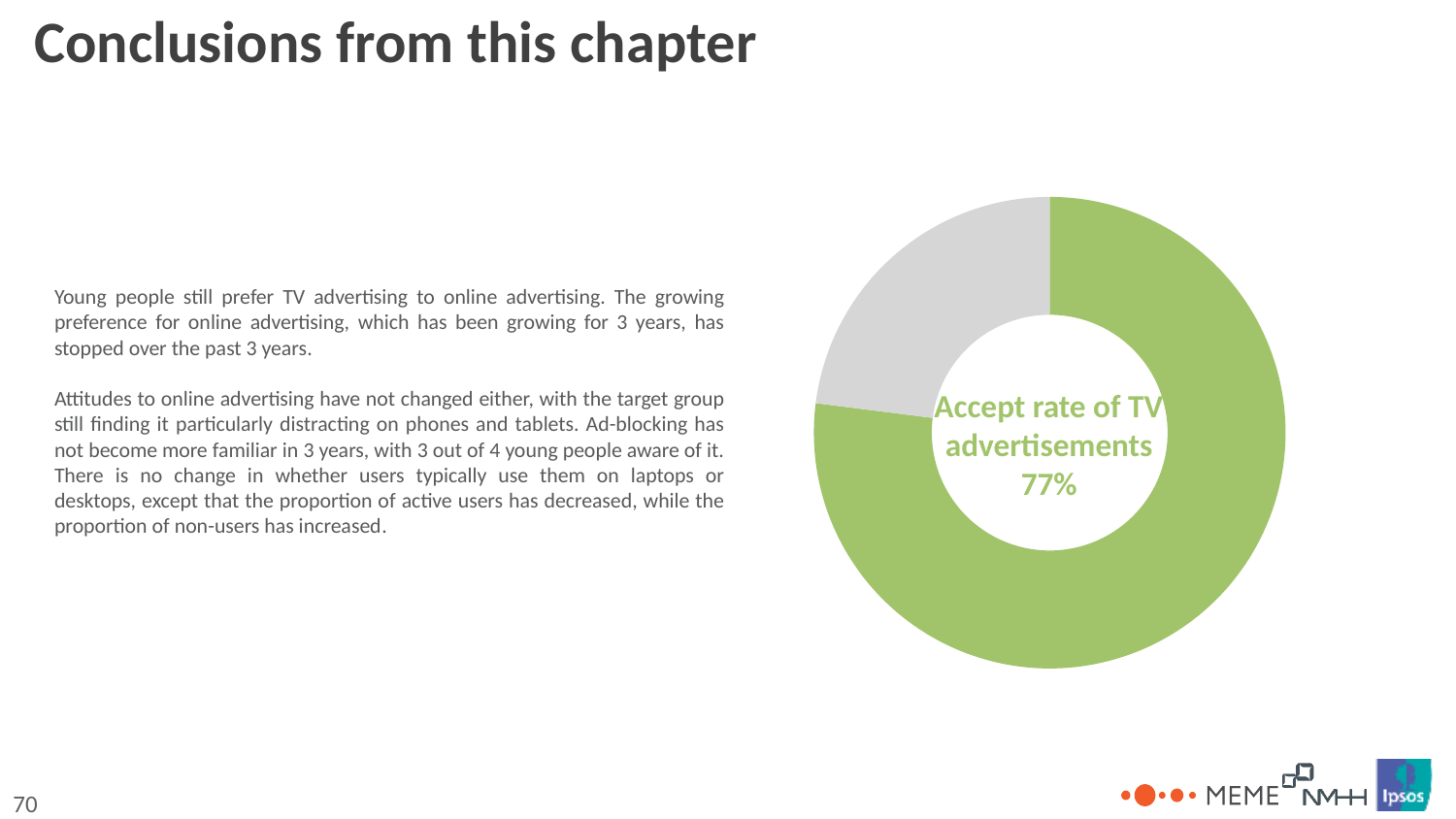
Which slice of the doughnut chart is larger, the green one or the grey one? The green one What colour is the slice representing the accept rate of TV advertisements? Green What share of the doughnut chart does the green slice represent? 77% Is the accept rate of TV advertisements greater or less than 50%? greater How many slices does the doughnut chart have? 2 What text is printed in the centre of the doughnut chart? Accept rate of TV advertisements 77% What kind of chart is shown on the slide? Doughnut (pie) chart What is the accept rate of TV advertisements shown in the chart? 77%